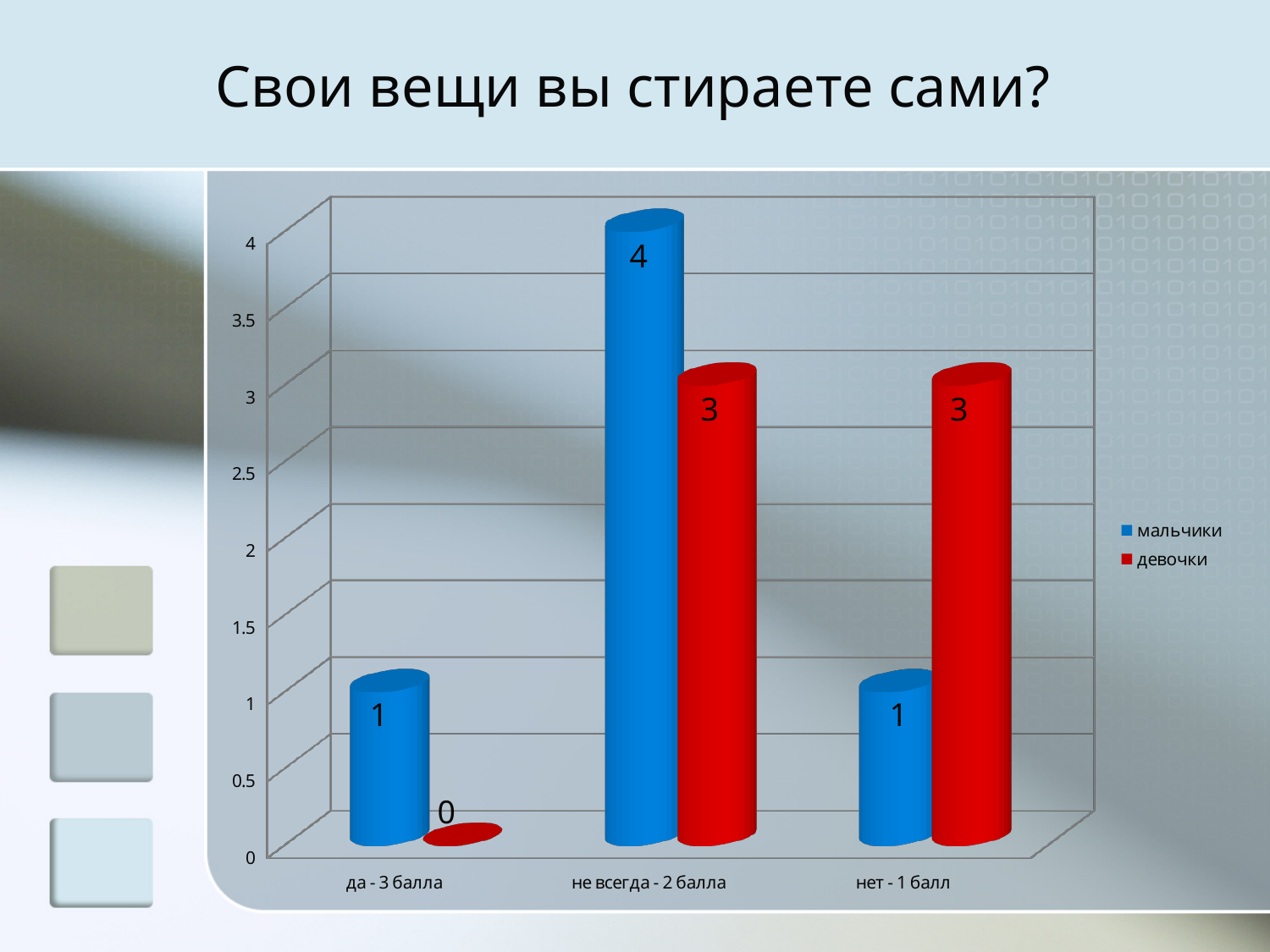
In which category is the value for девочки lowest? да - 3 балла What is the value for мальчики in the category 'не всегда - 2 балла'? 4 What is the title of the slide? Свои вещи вы стираете сами? What is the value for девочки in the category 'да - 3 балла'? 0 In the category 'нет - 1 балл', which series has the larger value, мальчики or девочки? девочки What is the value for девочки in the category 'нет - 1 балл'? 3 In which category is the value for мальчики highest? не всегда - 2 балла What is the value for мальчики in the category 'да - 3 балла'? 1 How many series does the legend list? 2 What kind of chart is shown on the slide? bar chart What is the difference between мальчики and девочки in the category 'не всегда - 2 балла'? 1 How many categories are shown on the x axis? 3